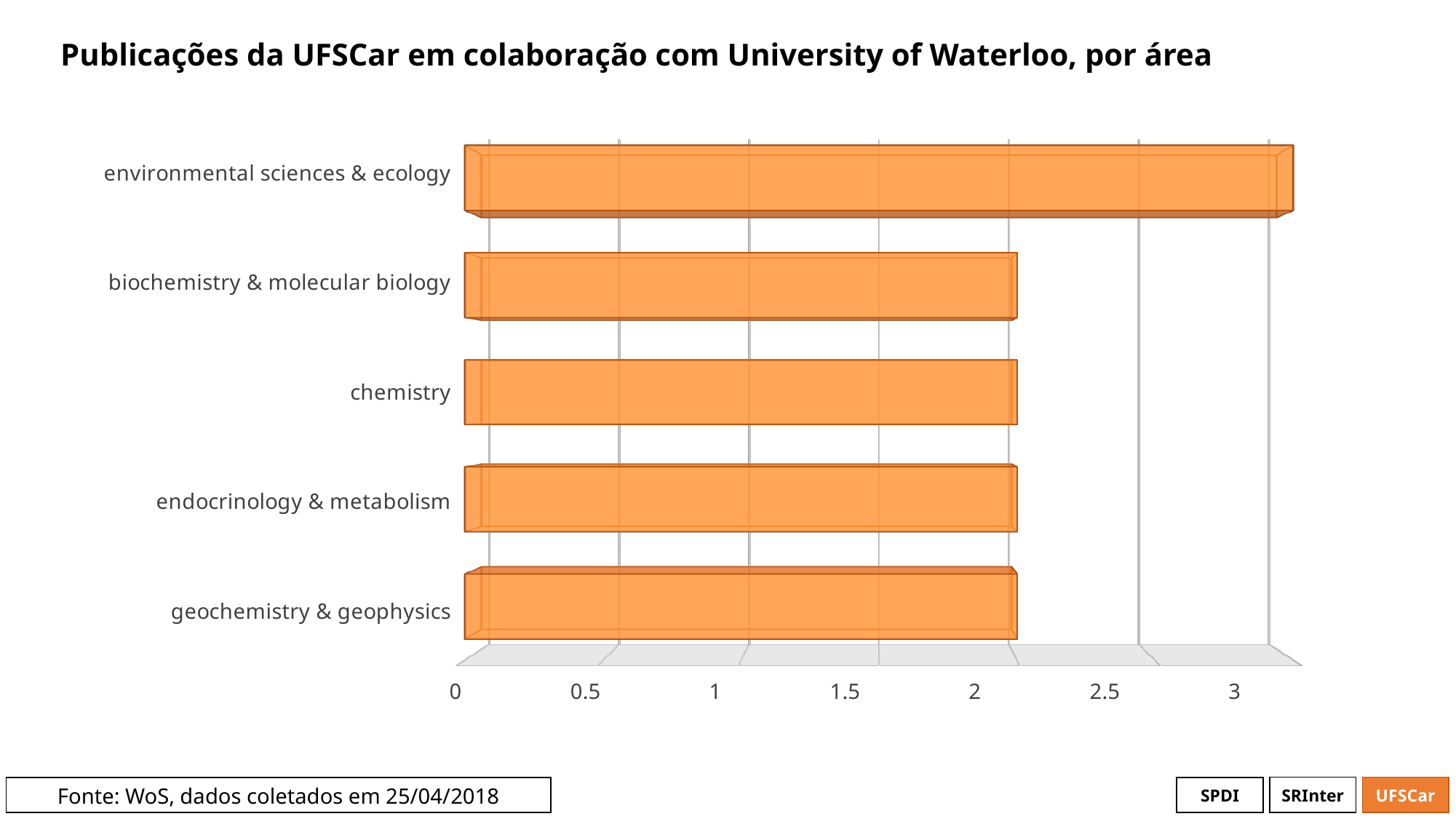
Is the value for chemistry greater or less than 2.5? less What kind of chart is shown on the slide? bar chart Is the value for geochemistry & geophysics greater or less than 1.5? greater Is the value for biochemistry & molecular biology greater or less than 1? greater What is the title of the chart? Publicações da UFSCar em colaboração com University of Waterloo, por área Which is larger, the value for environmental sciences & ecology or the value for chemistry? environmental sciences & ecology Which area has the highest number of publications? environmental sciences & ecology What colour are the bars in the chart? orange How many areas (categories) are shown in the chart? 5 Which is larger, the value for endocrinology & metabolism or the value for environmental sciences & ecology? environmental sciences & ecology